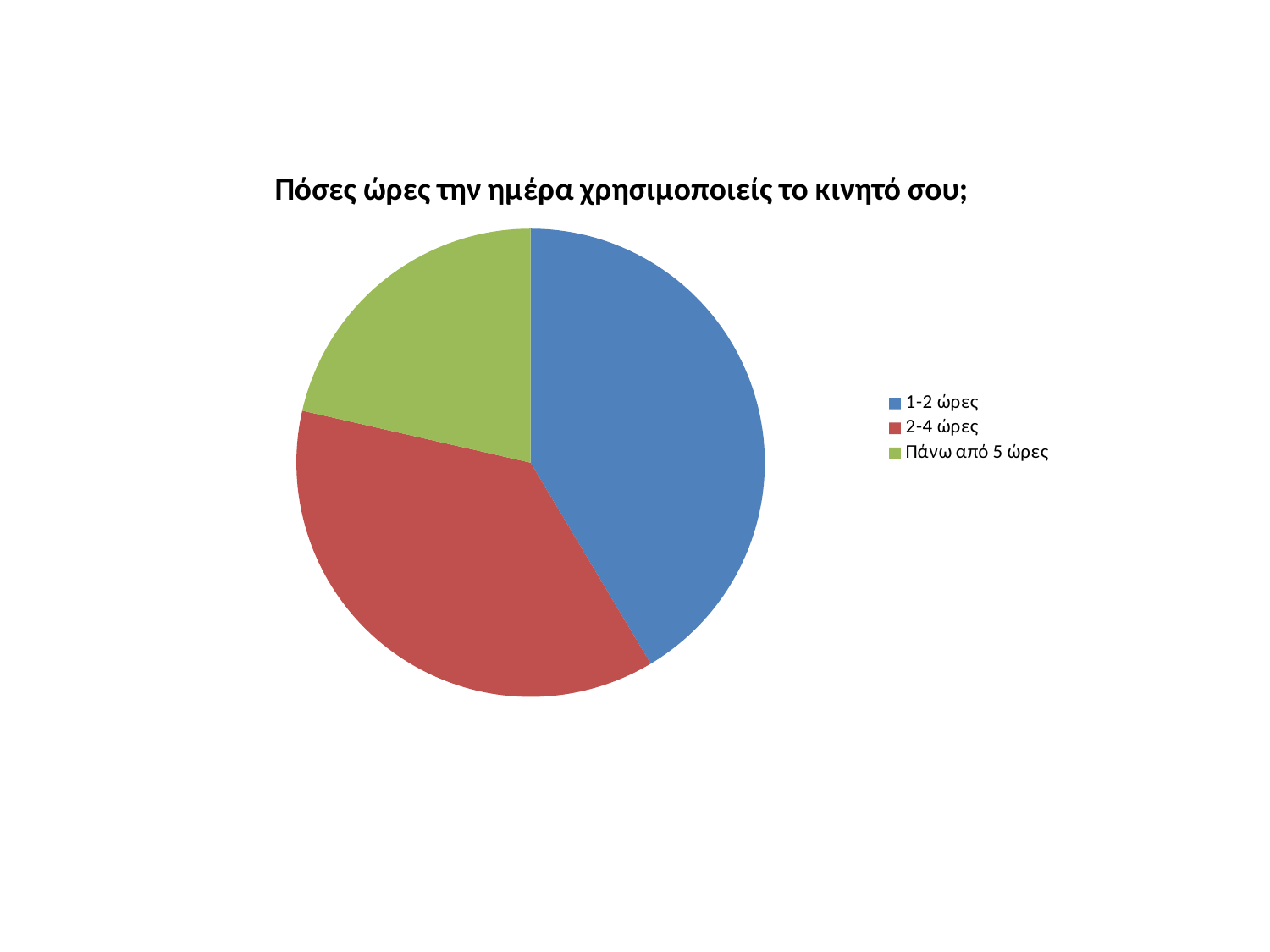
Which slice is larger: 1-2 ώρες or 2-4 ώρες? 1-2 ώρες Which slice is larger: 2-4 ώρες or Πάνω από 5 ώρες? 2-4 ώρες Which category has the largest slice of the pie? 1-2 ώρες Which category has the smallest slice of the pie? Πάνω από 5 ώρες How many slices does the pie chart have? 3 Which slice is larger: 1-2 ώρες or Πάνω από 5 ώρες? 1-2 ώρες What kind of chart is shown on the slide? pie chart What is the title of the chart? Πόσες ώρες την ημέρα χρησιμοποιείς το κινητό σου; Which colour represents the category 2-4 ώρες in the pie chart? red How many entries does the legend list? 3